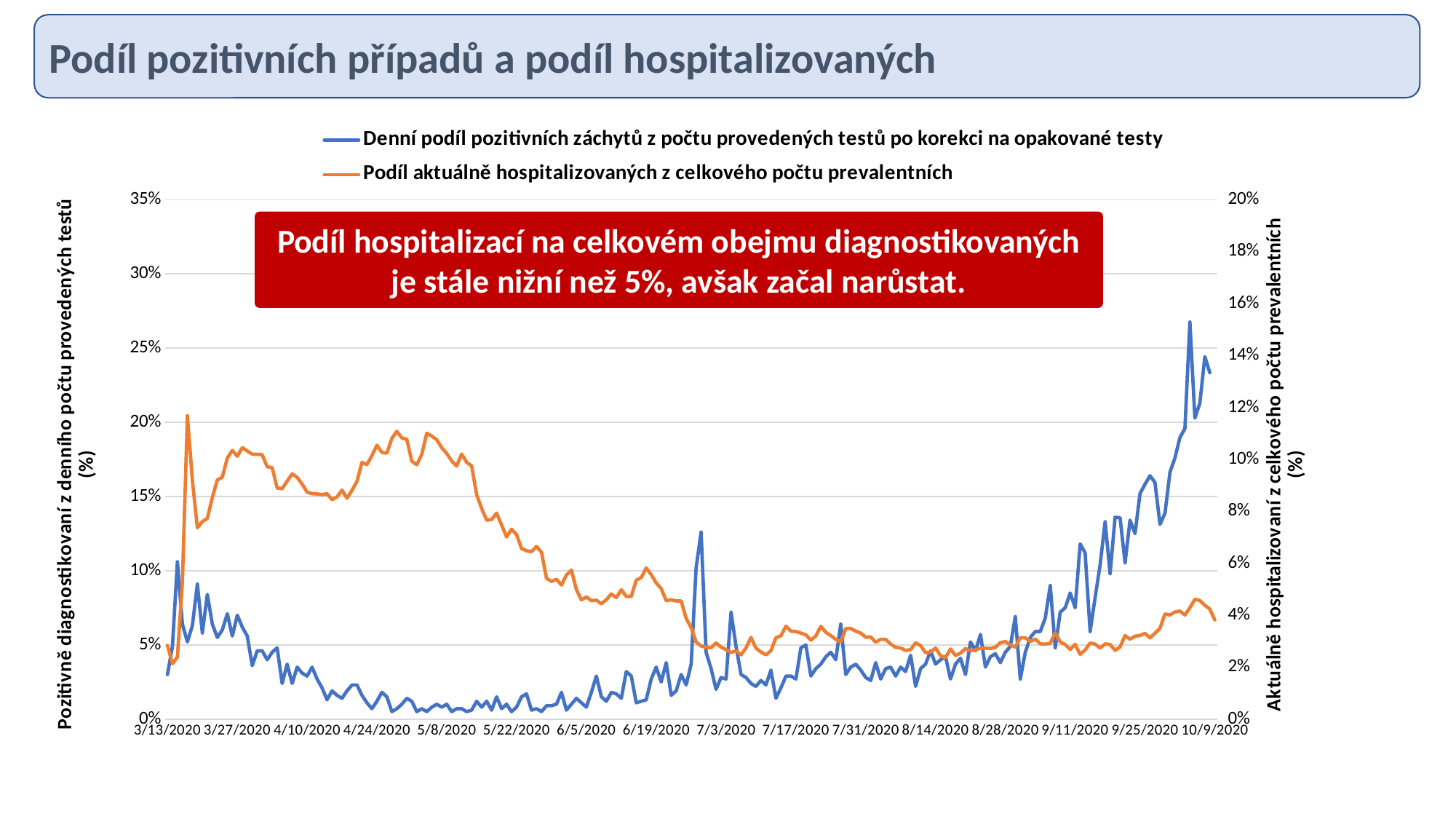
Is the value of the blue series (Denní podíl pozitivních záchytů) at 3/13/2020 greater or less than 5% on the left axis? less What is the highest tick value shown on the left vertical axis? 35% How many series does the legend list? 2 Does the blue series (Denní podíl pozitivních záchytů) rise or fall between 8/28/2020 and 10/9/2020? rise What type of chart is shown on the slide? line chart Which series is drawn in orange according to the legend? Podíl aktuálně hospitalizovaných z celkového počtu prevalentních Does the orange series (Podíl aktuálně hospitalizovaných) rise or fall between 5/8/2020 and 7/17/2020? fall Is the value of the orange series (Podíl aktuálně hospitalizovaných) at 10/9/2020 greater or less than 5% on the right axis? less How many date labels are shown along the x axis? 16